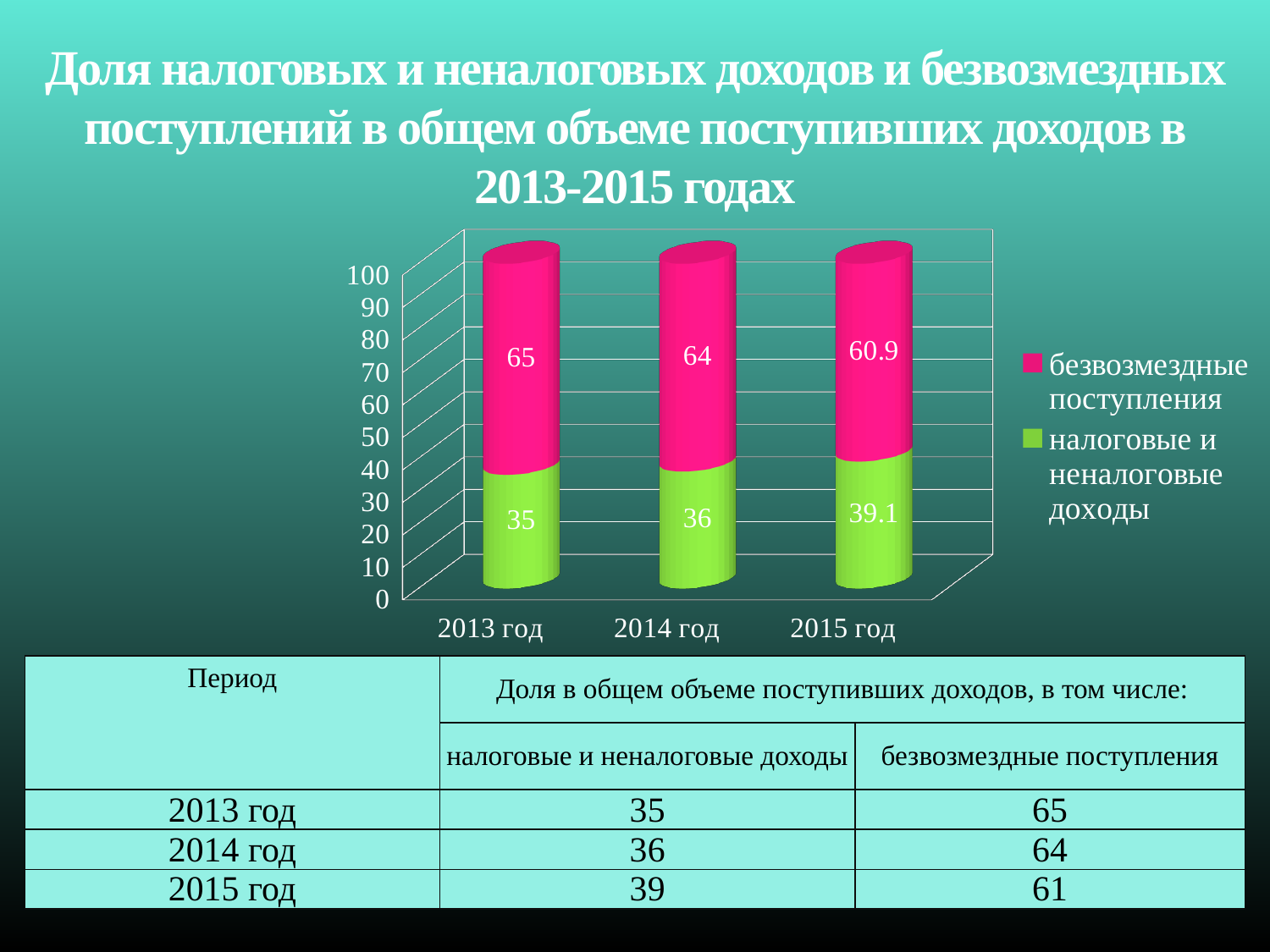
What is the total of the stacked bar for 2014 год in the chart? 100 What is the value of безвозмездные поступления for 2014 год in the chart? 64 What is the value of налоговые и неналоговые доходы for 2015 год in the chart? 39.1 What is the difference between безвозмездные поступления and налоговые и неналоговые доходы for 2013 год in the chart? 30 How many series does the chart legend list? 2 How many years (categories) are shown on the x axis of the chart? 3 What is the value of налоговые и неналоговые доходы for 2013 год in the chart? 35 What kind of chart is shown on the slide? stacked bar chart In which year is the value of безвозмездные поступления lowest in the chart? 2015 год Does the value of налоговые и неналоговые доходы rise or fall from 2013 год to 2015 год in the chart? rise What is the value of безвозмездные поступления for 2015 год in the chart? 60.9 In which year is the value of налоговые и неналоговые доходы highest in the chart? 2015 год